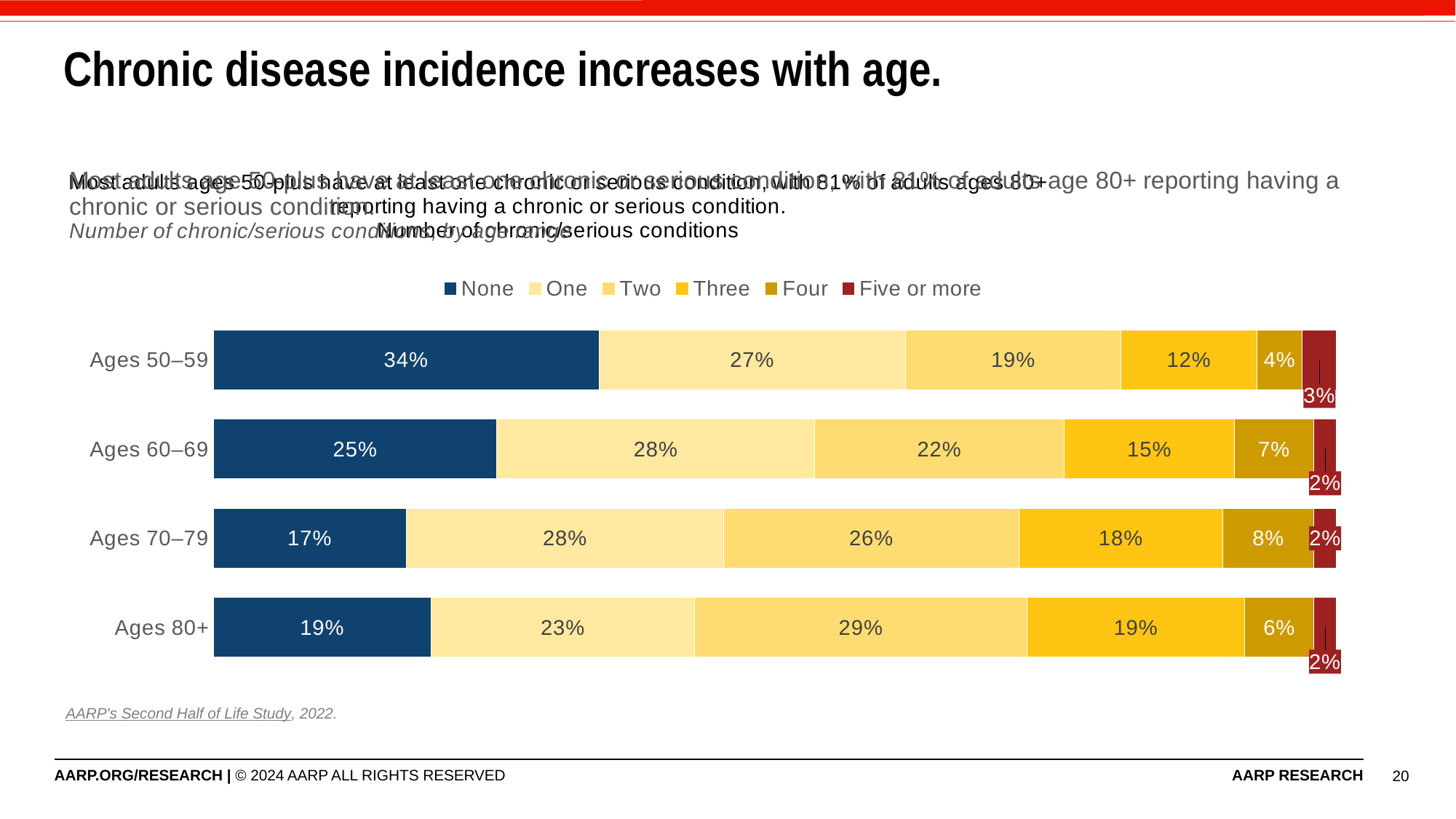
What percentage of adults ages 60–69 report having three chronic or serious conditions? 15% What percentage of adults ages 50–59 report having no chronic or serious conditions? 34% Which age group has the highest share reporting no chronic or serious conditions? Ages 50–59 How many series does the legend list? 6 What percentage of adults ages 70–79 report having four chronic or serious conditions? 8% What is the difference between the share of adults ages 50–59 and adults ages 80+ who report no chronic or serious conditions? 15% Which is larger: the share of adults ages 60–69 with two conditions or the share of adults ages 80+ with two conditions? Ages 80+ Which legend entry is shown in dark red? Five or more What percentage of adults ages 80+ report having two chronic or serious conditions? 29% Which age group has the lowest share reporting no chronic or serious conditions? Ages 70–79 How many age groups are shown in the chart? 4 What kind of chart is shown on the slide? Stacked bar chart